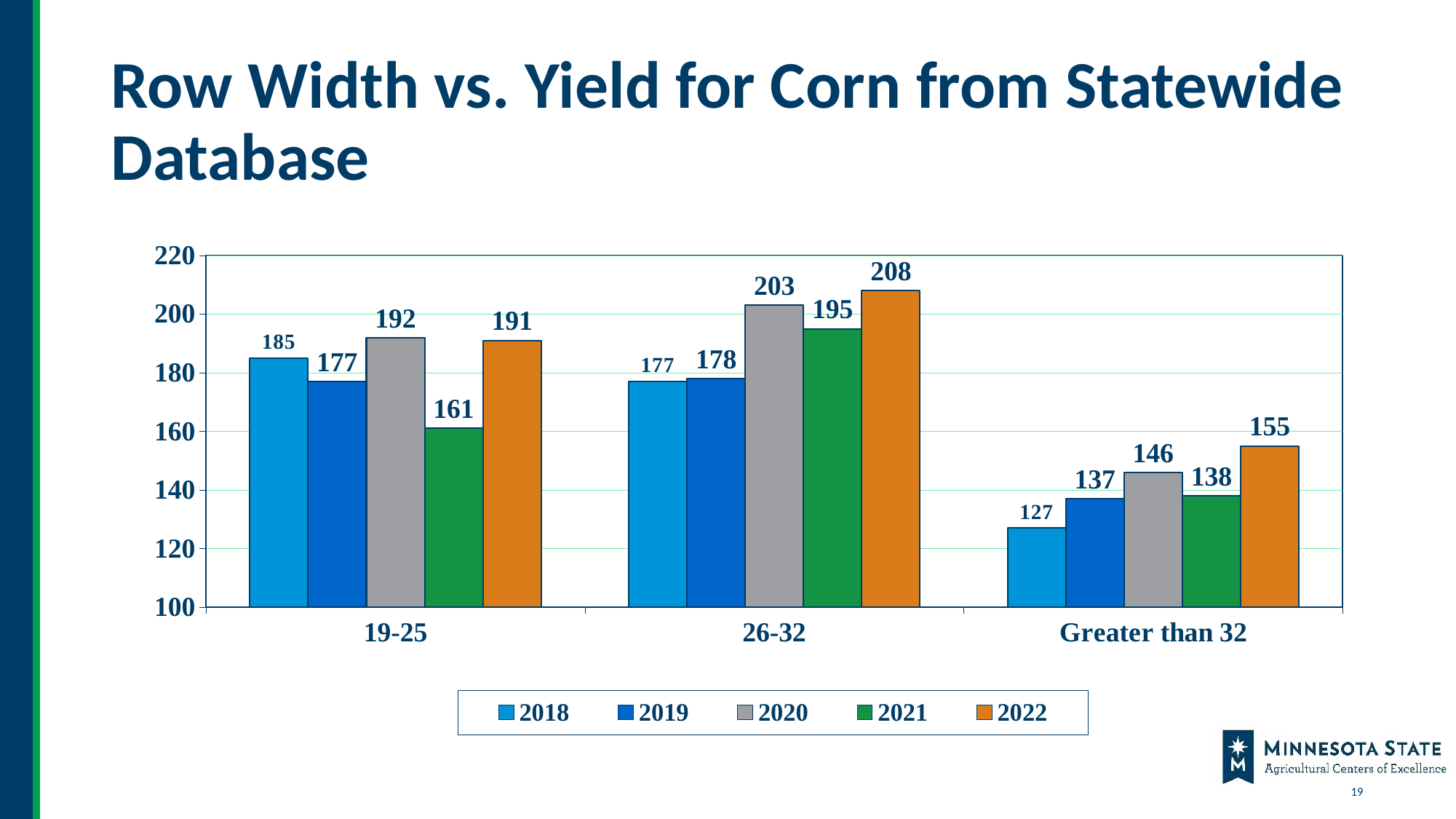
Which year has the lowest value in the Greater than 32 category? 2018 Is the value for 2019 in the Greater than 32 category greater or less than 140? less What is the value for 2018 in the Greater than 32 category? 127 What is the value for 2020 in the 26-32 row width category? 203 How many row width categories are shown on the x axis? 3 Which is larger in the 19-25 category: the value for 2020 or the value for 2022? 2020 What is the difference between the 2022 and 2018 values in the 26-32 category? 31 What kind of chart is shown on the slide? bar chart What is the value for 2021 in the 19-25 category? 161 Which colour represents 2022 in the legend? orange How many series does the legend list? 5 Which row width category has the highest value for 2022? 26-32